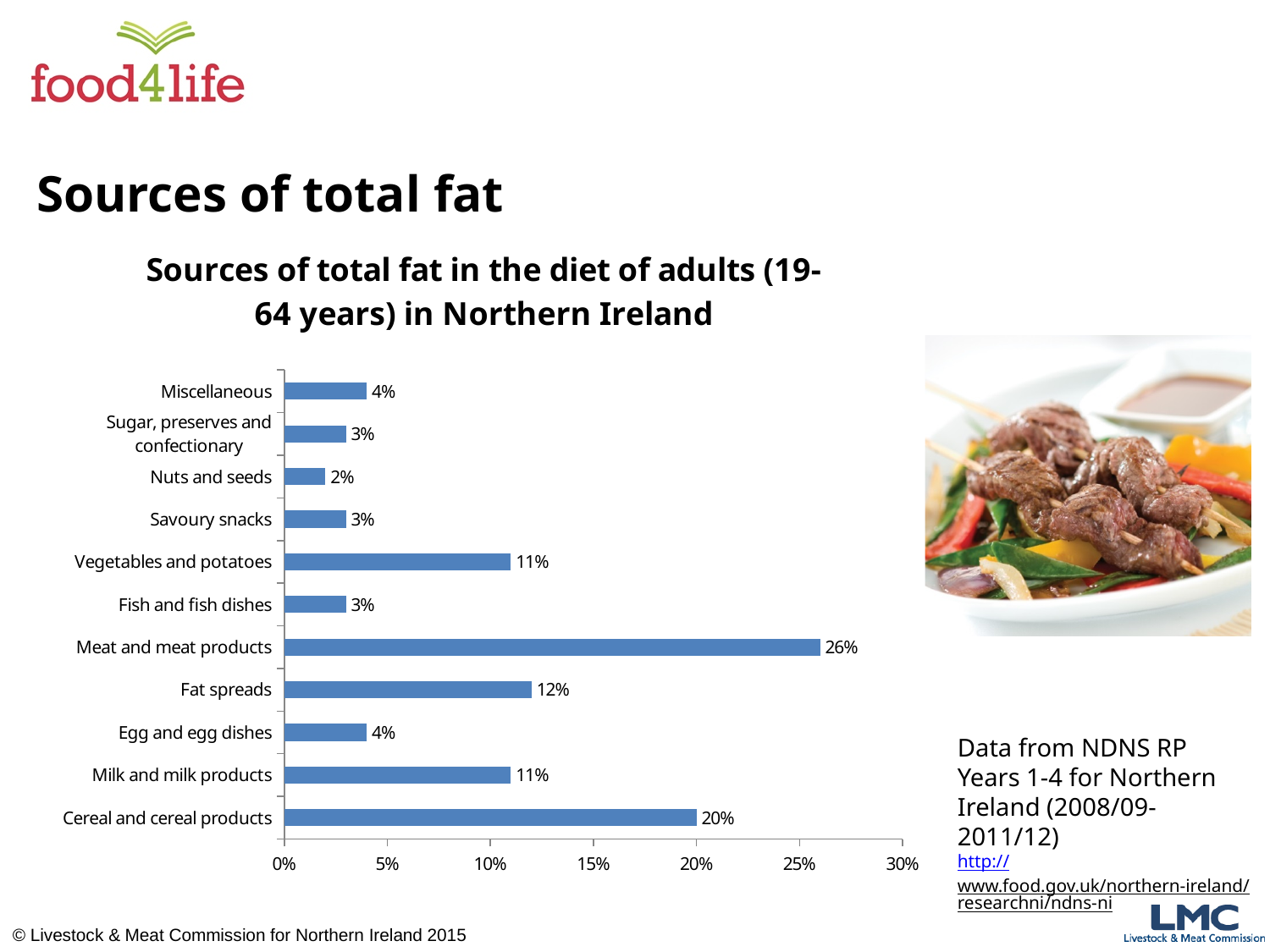
What is the difference between the values for Meat and meat products and Cereal and cereal products? 6% How many categories are shown in the chart? 11 Which category has the highest value? Meat and meat products What kind of chart is shown on the slide? Bar chart Which is larger, the value for Fat spreads or the value for Milk and milk products? Fat spreads Is the value for Cereal and cereal products greater or less than 15%? greater What is the value for Vegetables and potatoes? 11% What is the title of the chart? Sources of total fat in the diet of adults (19-64 years) in Northern Ireland What is the value for Meat and meat products? 26% Which category has the lowest value? Nuts and seeds What is the value for Fat spreads? 12% What is the value for Cereal and cereal products? 20%